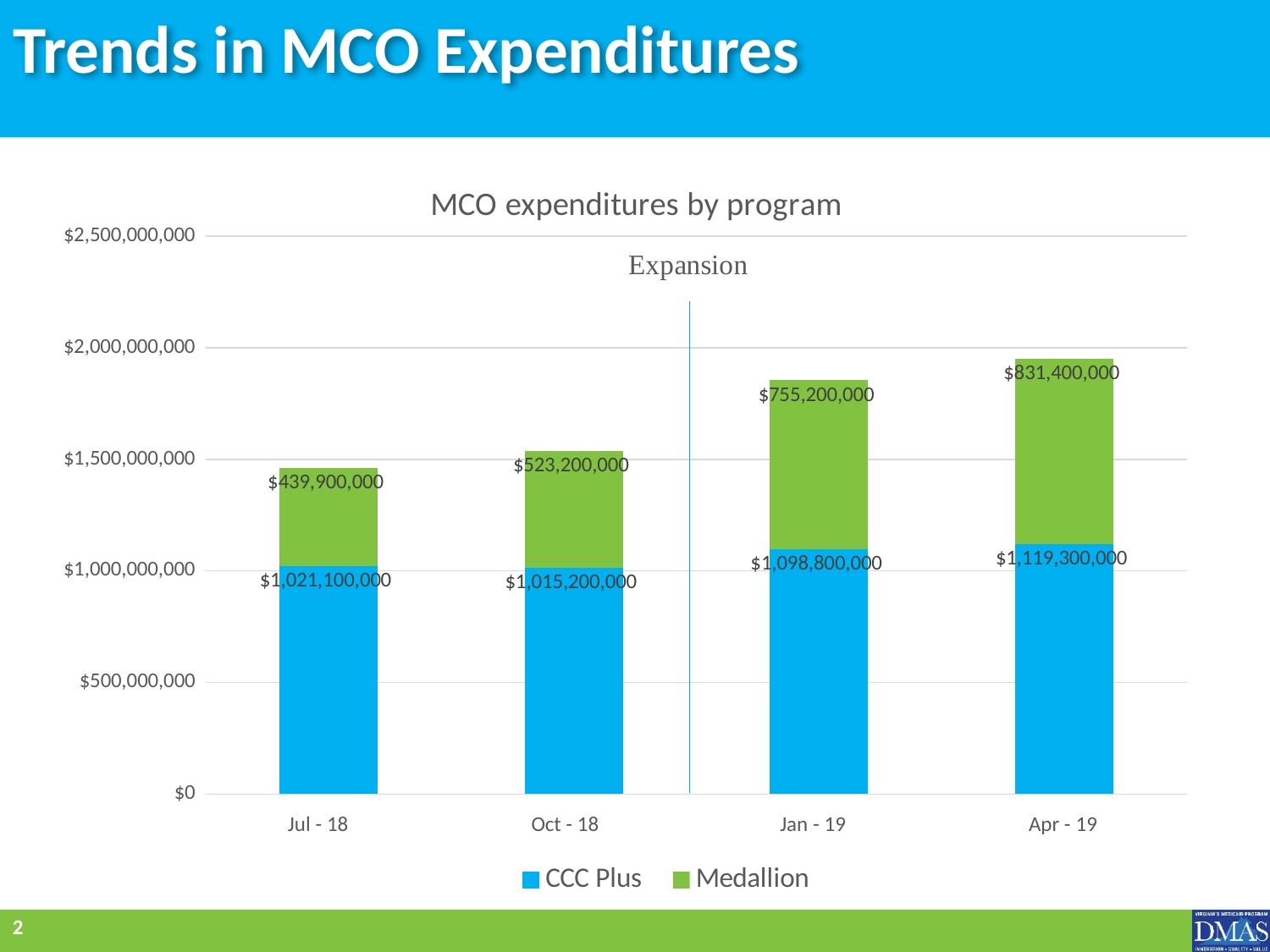
What kind of chart is shown? Stacked bar chart What is the Medallion value for Oct - 18? $523,200,000 What is the Medallion value for Apr - 19? $831,400,000 How many series does the legend list? 2 Which period has the highest Medallion value? Apr - 19 Which is larger, the CCC Plus value for Jul - 18 or the CCC Plus value for Apr - 19? Apr - 19 What is the CCC Plus value for Jan - 19? $1,098,800,000 What is the total of the stacked bar for Jul - 18? $1,461,000,000 What is the total of the stacked bar for Apr - 19? $1,950,700,000 Which period has the lowest CCC Plus value? Oct - 18 What is the difference between the Medallion values for Jan - 19 and Jul - 18? $315,300,000 How many periods are shown on the x axis? 4